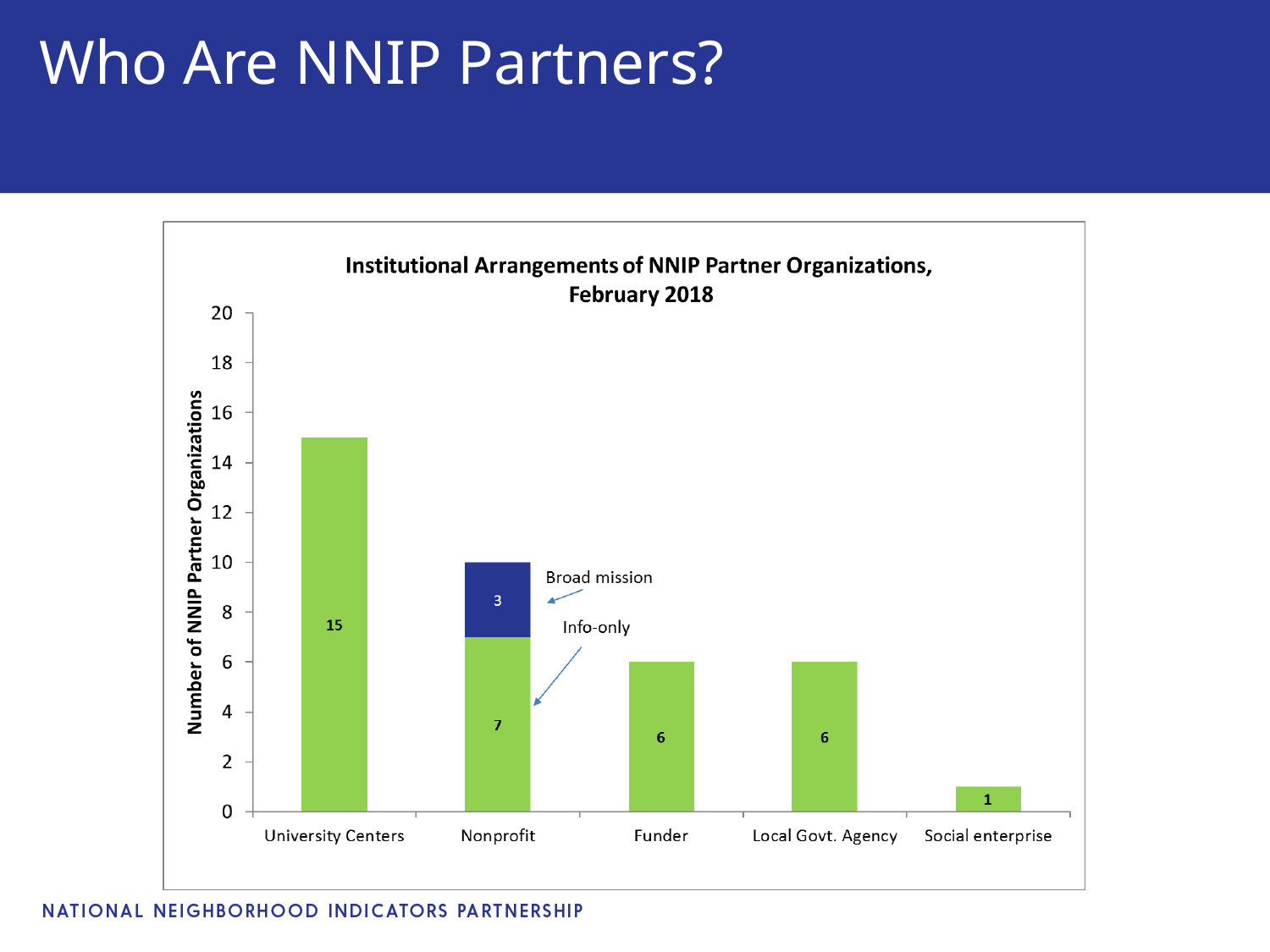
How many categories are shown on the x axis? 5 What is the difference between the values for University Centers and Funder? 9 Which category has the lowest number of NNIP partner organizations? Social enterprise What is the Broad mission value for Nonprofit? 3 What kind of chart is this? Bar chart Which is larger, the value for Funder or the value for Social enterprise? Funder Which category has the highest number of NNIP partner organizations? University Centers What is the Info-only value for Nonprofit? 7 What is the value for University Centers? 15 What is the value for Social enterprise? 1 What is the title of the chart? Institutional Arrangements of NNIP Partner Organizations, February 2018 What is the total of the stacked Nonprofit bar? 10